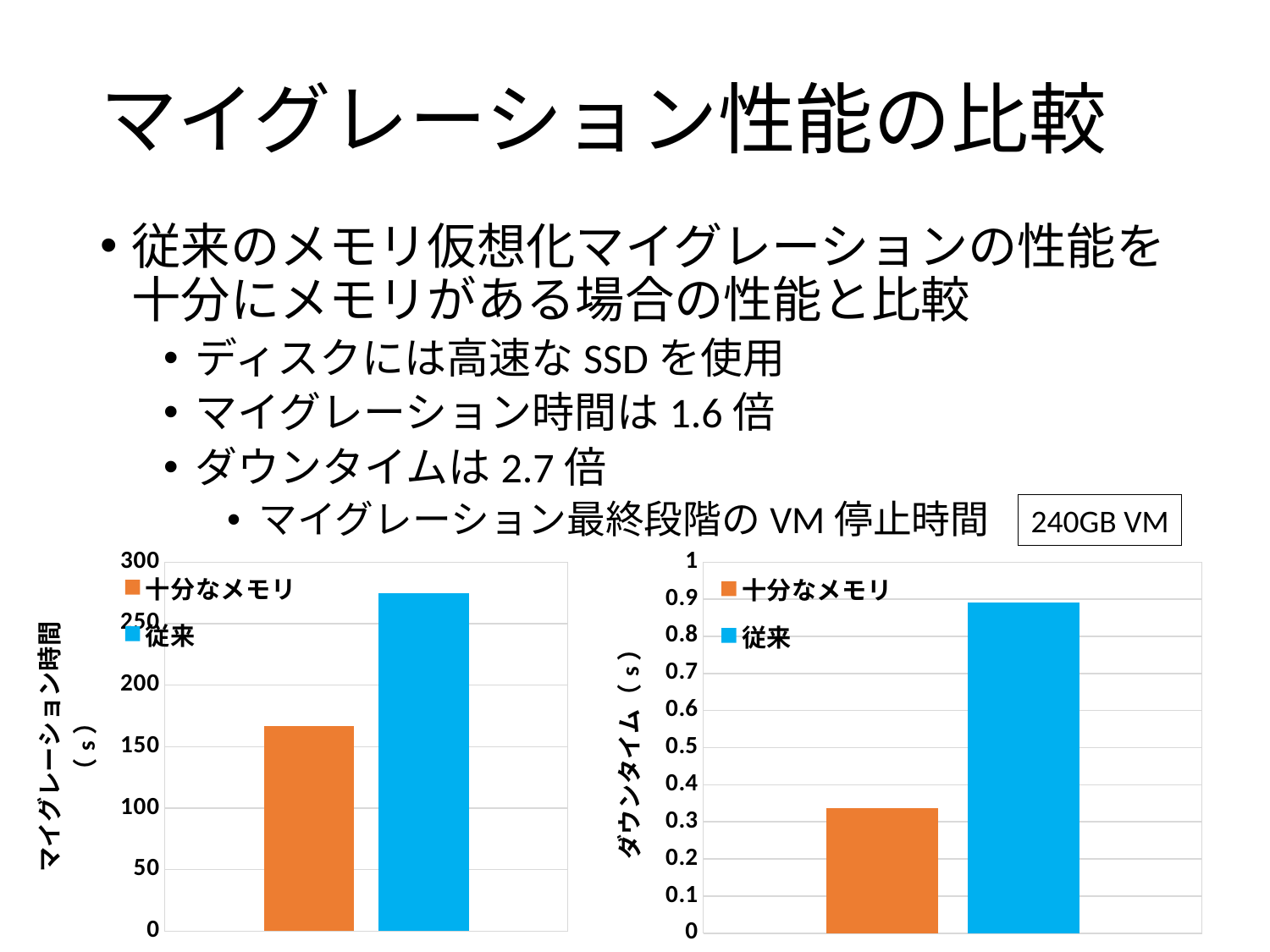
In the left chart (マイグレーション時間), what colour is the bar for 従来? blue In the left chart (マイグレーション時間), is the value for 従来 greater or less than 250? greater In the right chart (ダウンタイム), is the value for 十分なメモリ greater or less than 0.3? greater In the left chart (マイグレーション時間), which series has the higher value, 十分なメモリ or 従来? 従来 In the right chart (ダウンタイム), is the value for 従来 greater or less than 0.8? greater What kind of chart is the right chart (ダウンタイム)? bar chart How many series does the legend of the left chart (マイグレーション時間) list? 2 In the right chart (ダウンタイム), which series has the lower value? 十分なメモリ What is the y-axis label of the right chart? ダウンタイム（s）